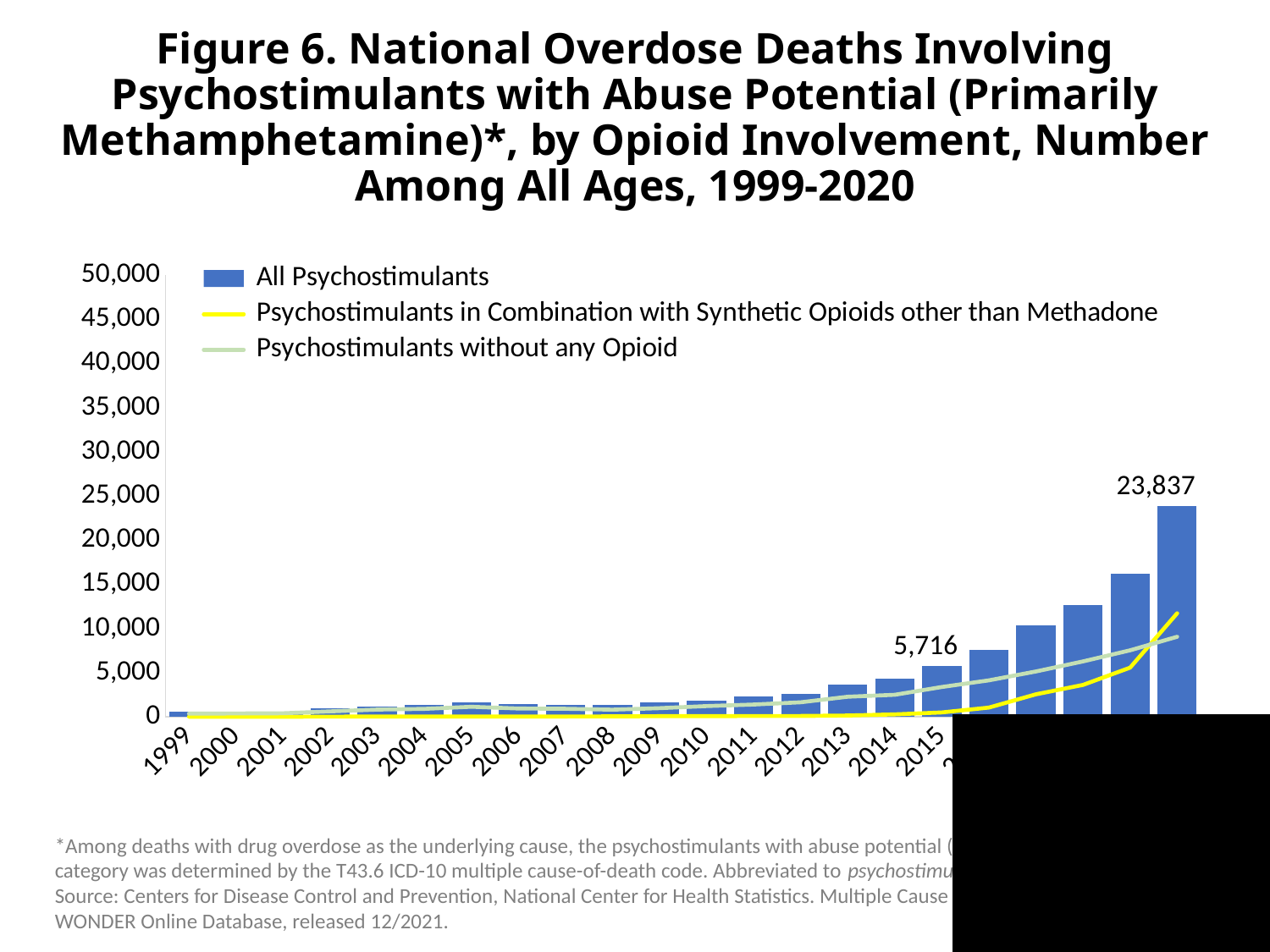
Which year has the larger All Psychostimulants value, 2010 or 2015? 2015 What colour are the All Psychostimulants bars? Blue How many series does the legend list? 3 What is the number of All Psychostimulants overdose deaths in 2015? 5,716 What is the difference between the tallest bar's labeled value (23,837) and the 2015 value (5,716)? 18,121 Is the All Psychostimulants value for 2015 greater or less than 5,000? greater Is the tallest bar's value greater or less than 20,000? greater What is the labeled value of the tallest bar in the chart? 23,837 What kind of chart is shown on the slide? Bar chart with line series Do the All Psychostimulants bars generally rise or fall from 1999 onward? rise Which series is drawn as the yellow line? Psychostimulants in Combination with Synthetic Opioids other than Methadone Is the All Psychostimulants value for 2010 greater or less than 5,000? less